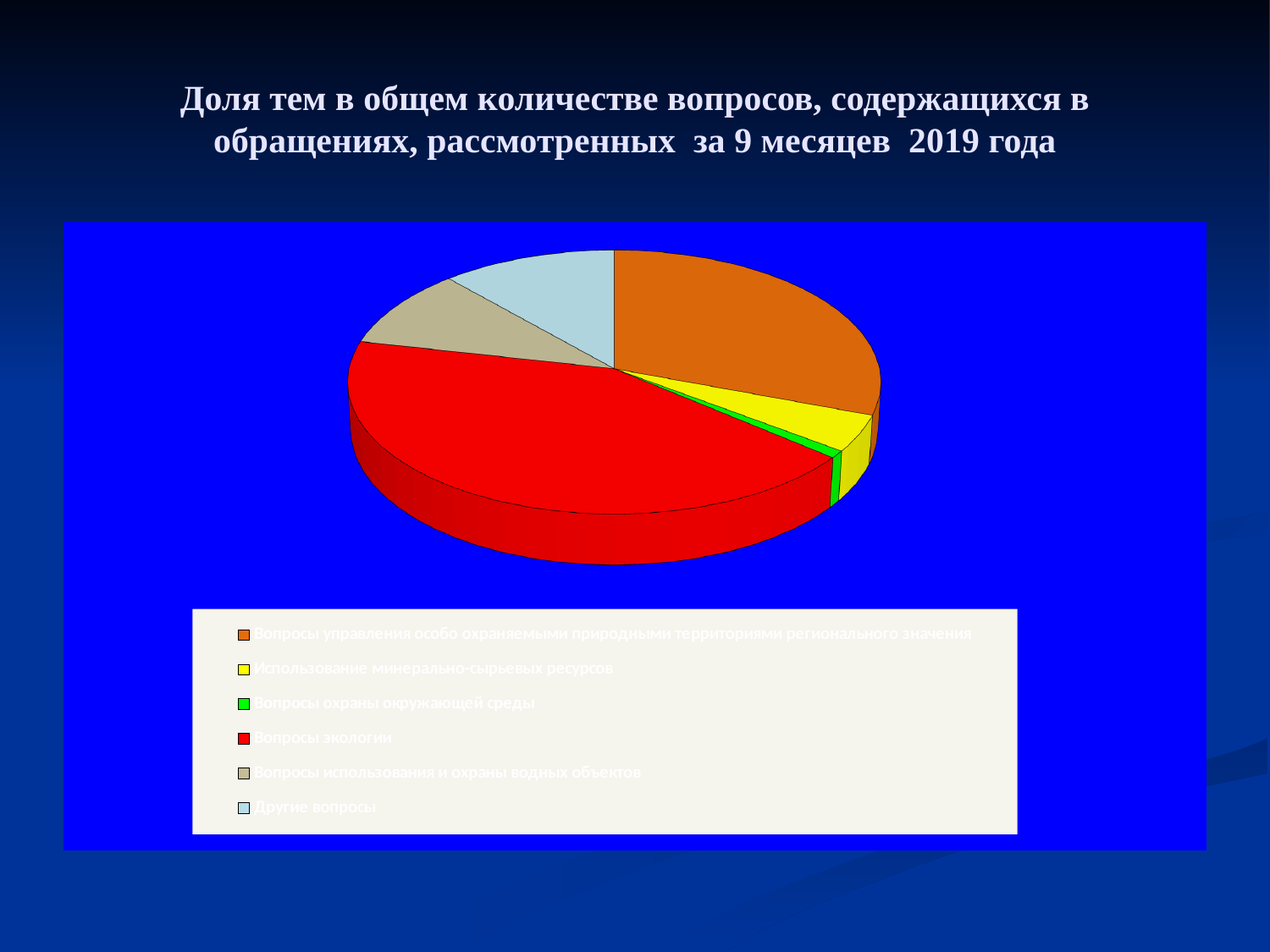
What kind of chart is shown on the slide? pie chart Which slice is larger: Вопросы экологии or Другие вопросы? Вопросы экологии Which category has the largest slice of the pie chart? Вопросы экологии Which slice is larger: Вопросы управления особо охраняемыми природными территориями регионального значения or Использование минерально-сырьевых ресурсов? Вопросы управления особо охраняемыми природными территориями регионального значения Which category has the smallest slice of the pie chart? Вопросы охраны окружающей среды How many entries does the legend of the pie chart list? 6 What is the title of the slide? Доля тем в общем количестве вопросов, содержащихся в обращениях, рассмотренных за 9 месяцев 2019 года Which slice is larger: Использование минерально-сырьевых ресурсов or Вопросы охраны окружающей среды? Использование минерально-сырьевых ресурсов How many slices does the pie chart have? 6 Which colour represents Другие вопросы in the pie chart? light blue